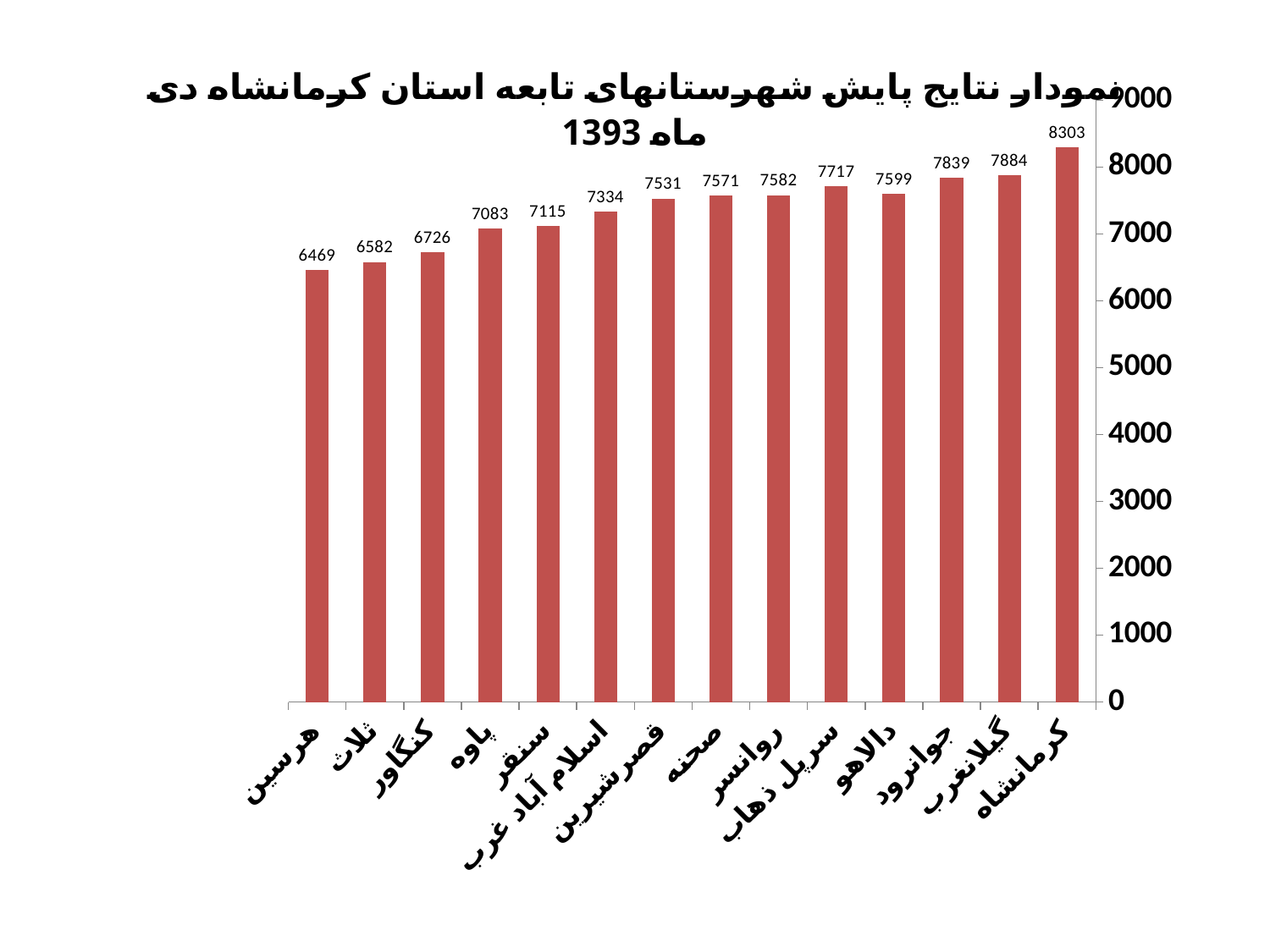
Which category has the highest value? کرمانشاه How many categories are shown on the x axis? 14 What kind of chart is shown on the slide? bar chart What is the value for جوانرود? 7839 Which category has the lowest value? هرسین Which is larger, the value for سرپل ذهاب or the value for دالاهو? سرپل ذهاب What is the difference between the values for گیلانغرب and جوانرود? 45 What is the value for کرمانشاه? 8303 What is the difference between the values for کرمانشاه and هرسین? 1834 What is the value for هرسین? 6469 What is the value for اسلام آباد غرب? 7334 Is the value for پاوه greater or less than 7000? greater